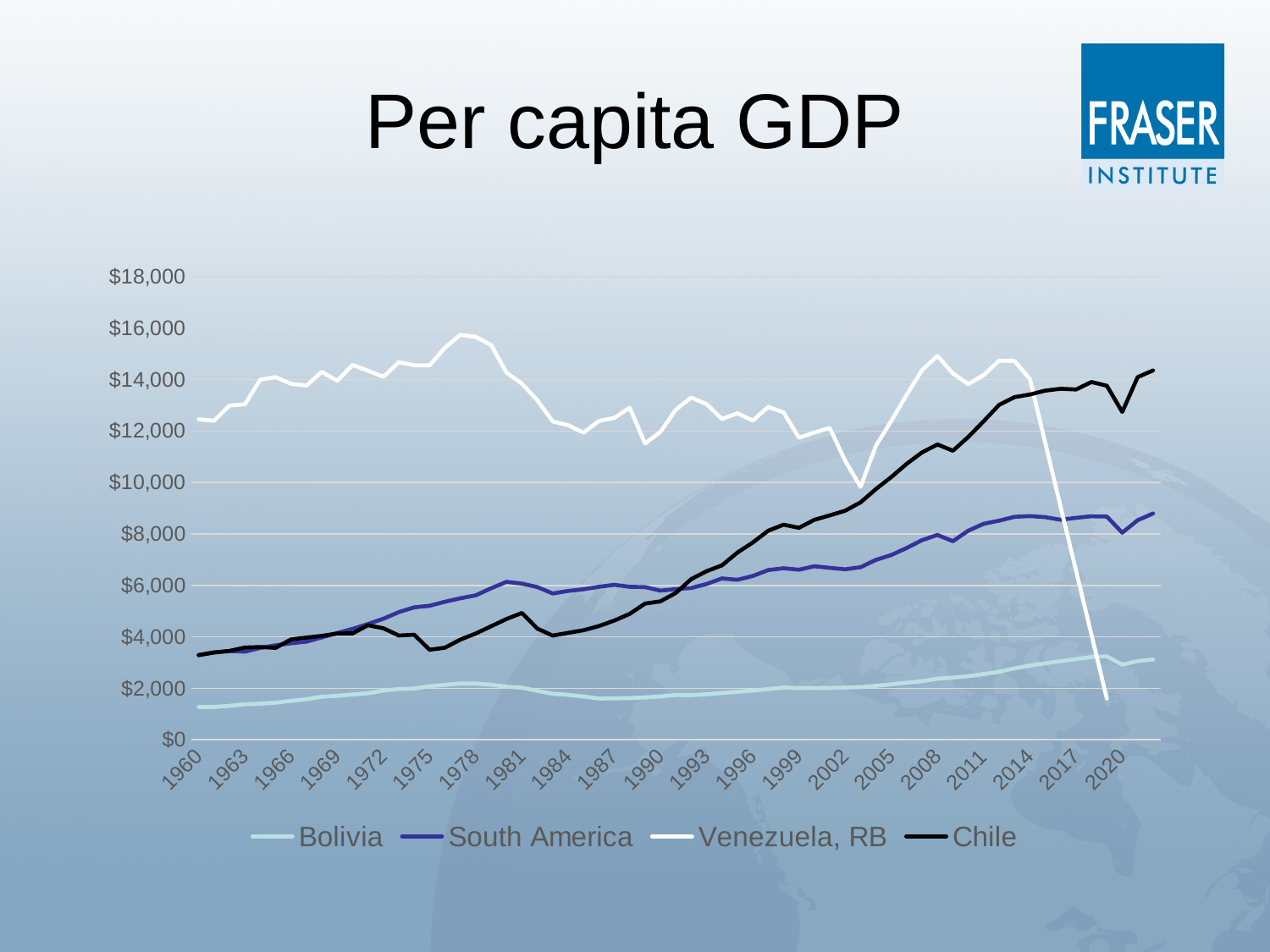
What is the title of the chart? Per capita GDP Is the value for Chile in 2020 greater or less than $10,000? greater Which series has the lowest per capita GDP in 1960? Bolivia How many series does the legend list? 4 Which series has the highest per capita GDP in 1960? Venezuela, RB Is the value for Bolivia in 1960 greater or less than $2,000? less Does the South America line generally rise or fall from 1960 to 2020? rise What kind of chart is shown on the slide? line chart Which series are listed in the legend? Bolivia, South America, Venezuela, RB, Chile Is the value for Venezuela, RB in 1978 greater or less than $14,000? greater In 2014, which is higher, Chile or South America? Chile Which series shows a sharp fall after 2014? Venezuela, RB